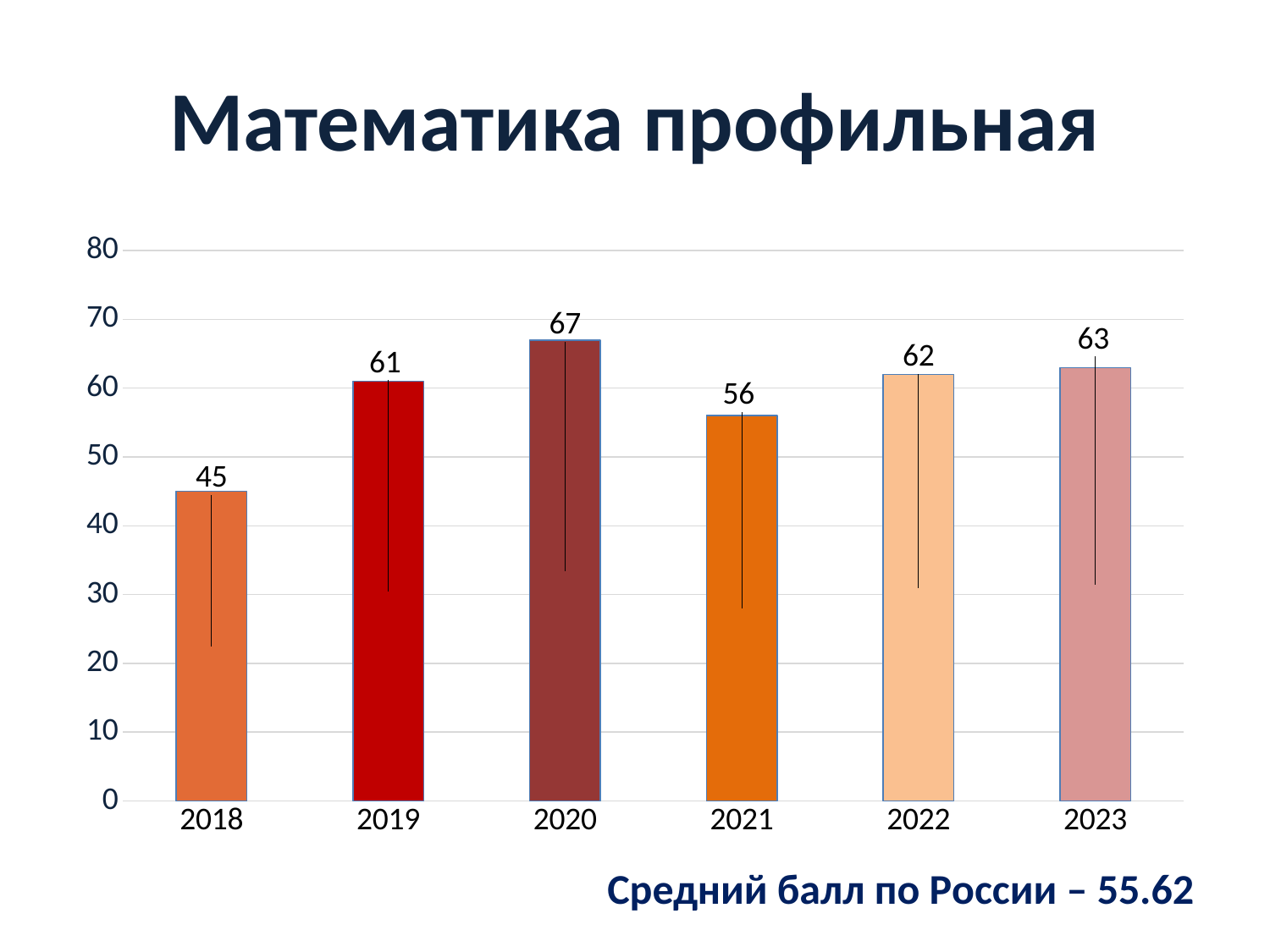
What kind of chart is shown on the slide? bar chart What is the value for 2023? 63 Which is larger, the value for 2019 or the value for 2021? 2019 What is the value for 2018? 45 Is the value for 2020 greater or less than 60? greater What is the title of the slide? Математика профильная What is the difference between the values for 2022 and 2021? 6 Which year has the highest value? 2020 How many years are shown on the chart? 6 What is the value for 2021? 56 What is the difference between the values for 2020 and 2018? 22 Which year has the lowest value? 2018